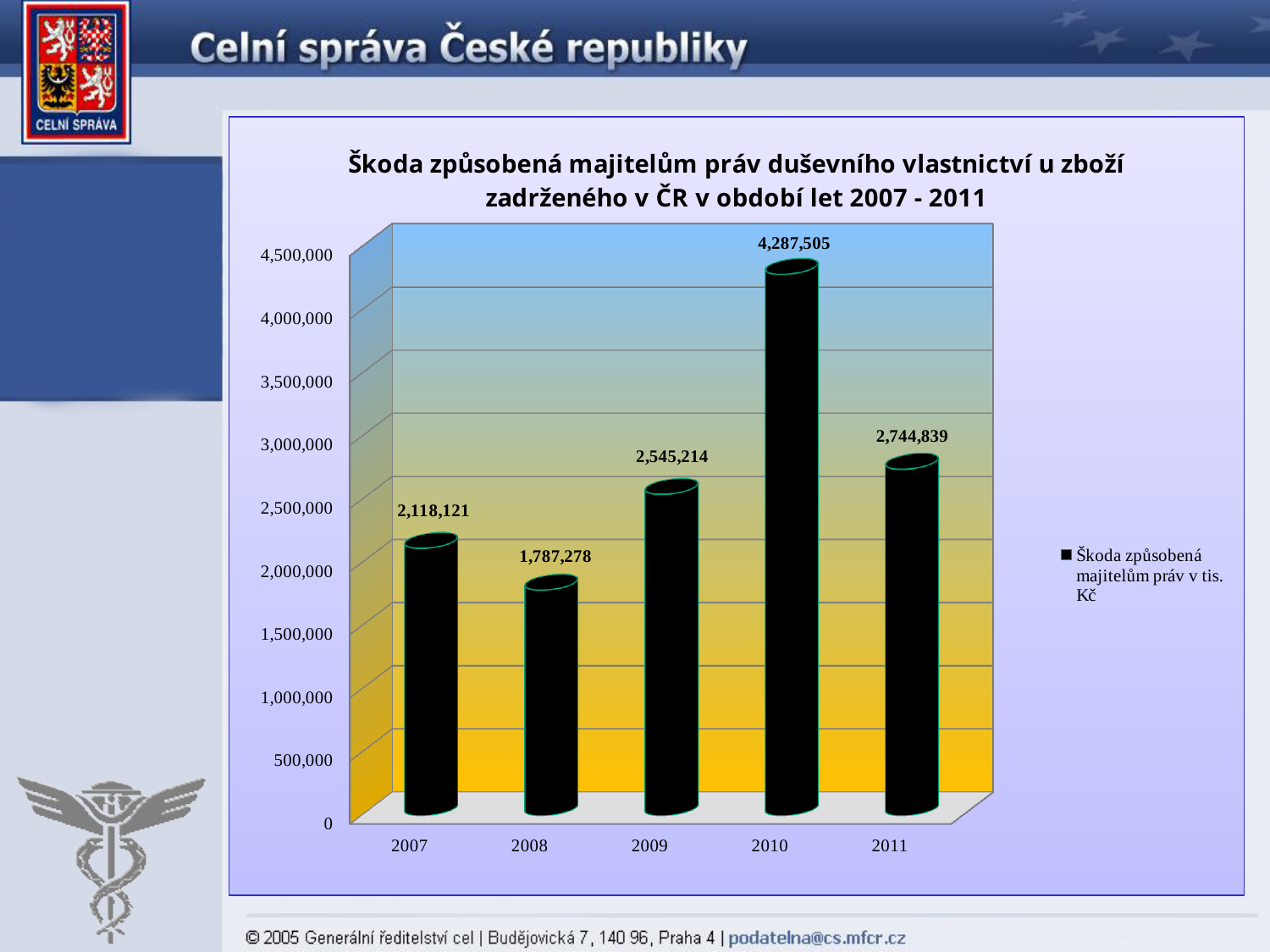
How many years are shown on the x axis? 5 What is the value for 2010? 4,287,505 What is the value for 2011? 2,744,839 What is the legend entry for the series? Škoda způsobená majitelům práv v tis. Kč What is the difference between the values for 2011 and 2007? 626,718 What is the value for 2008? 1,787,278 What is the difference between the values for 2010 and 2009? 1,742,291 Is the value for 2007 greater or less than 2,000,000? greater Which year has the highest value? 2010 Which year has the lowest value? 2008 Which is larger, the value for 2009 or the value for 2011? 2011 What kind of chart is shown on the slide? bar chart